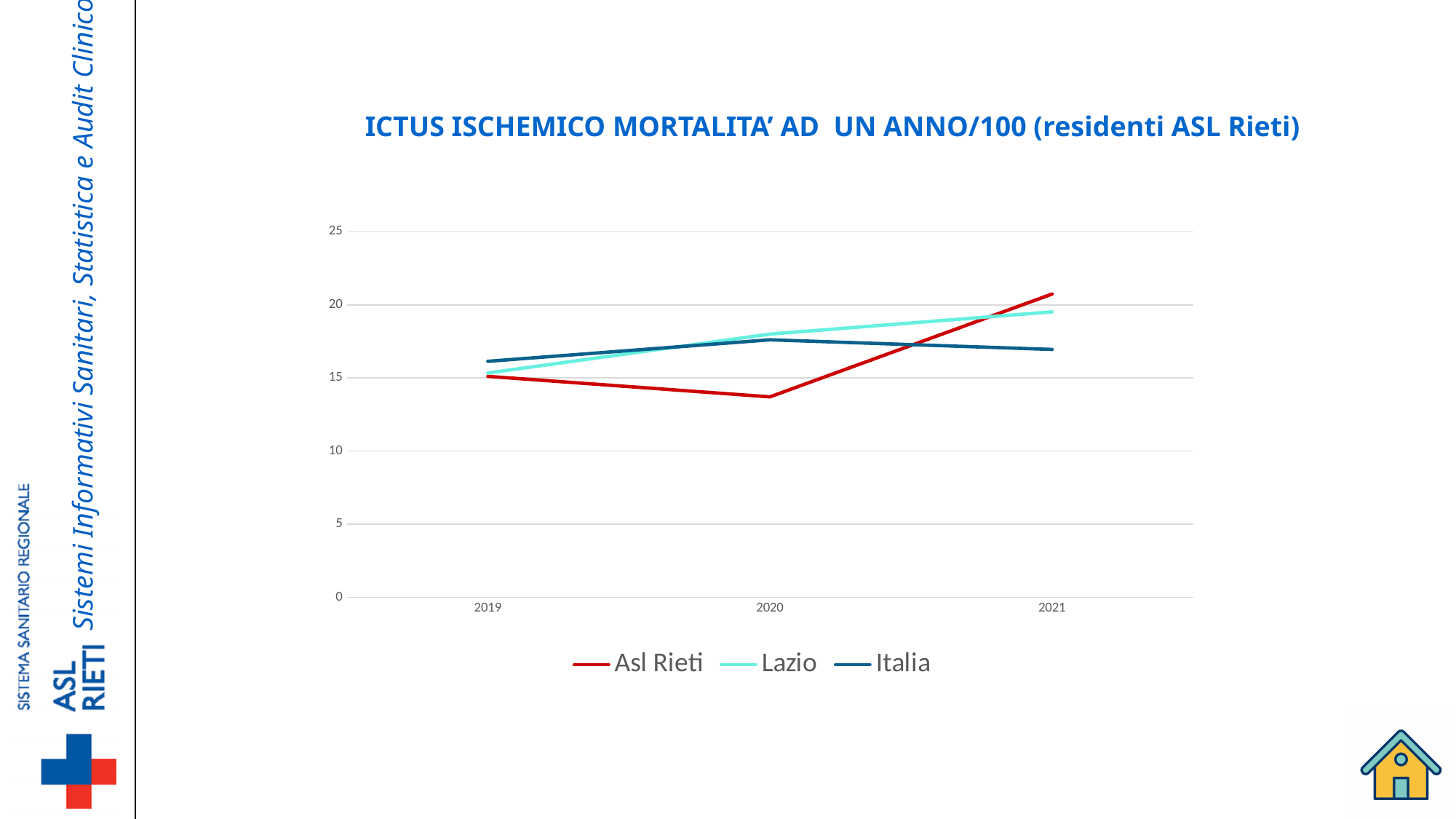
How many years are shown on the x axis? 3 Which series is drawn in red? Asl Rieti Is the value for Italia in 2019 greater or less than 15? greater Is the value for Asl Rieti in 2021 greater or less than 20? greater In 2020, which series has the lowest value? Asl Rieti In 2021, is the value for Lazio larger or smaller than the value for Italia? larger In 2021, which series has the highest value? Asl Rieti Does the Lazio line rise or fall from 2019 to 2021? rise What kind of chart is shown on the slide? line chart How many series does the legend list? 3 Is the value for Asl Rieti in 2020 greater or less than 15? less